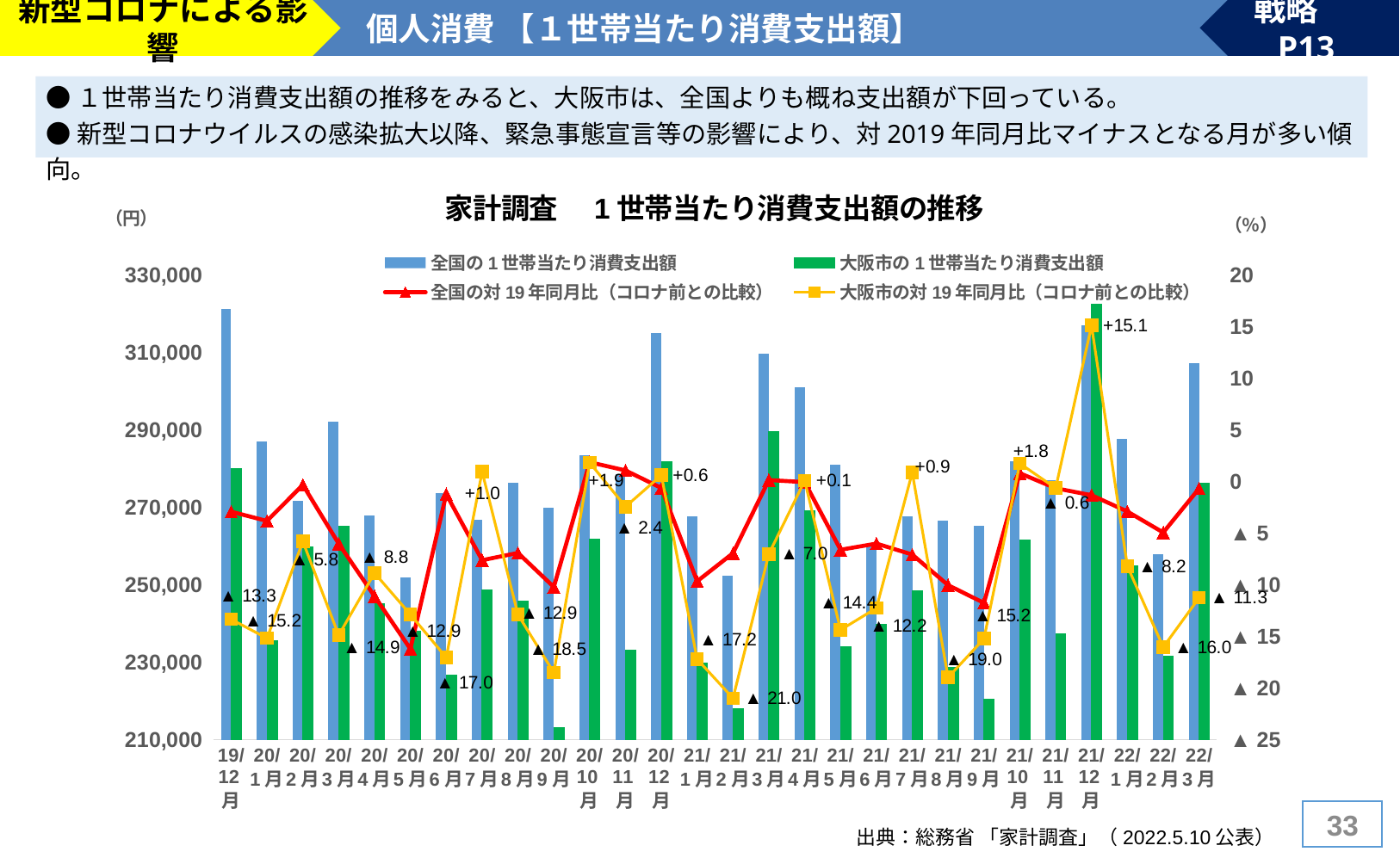
What is the value of 大阪市の対19年同月比 for 21/12月? +15.1 How many months are plotted along the x axis? 28 What is the value of 大阪市の対19年同月比 for 21/2月? ▲21.0 In which month is 大阪市の対19年同月比 lowest? 21/2月 What is the difference between 大阪市の対19年同月比 for 21/10月 (+1.8) and 21/11月 (▲0.6)? 2.4 percentage points What is the title of the chart? 家計調査 １世帯当たり消費支出額の推移 For 19/12月, which is larger: 全国の1世帯当たり消費支出額 or 大阪市の1世帯当たり消費支出額? 全国の1世帯当たり消費支出額 What kind of chart is shown on the slide? A combined bar and line chart Is the value of 全国の1世帯当たり消費支出額 for 19/12月 greater or less than 310,000? greater In which month is 大阪市の対19年同月比 highest? 21/12月 How many series does the legend list? 4 What is the value of 大阪市の対19年同月比 for 20/7月? +1.0